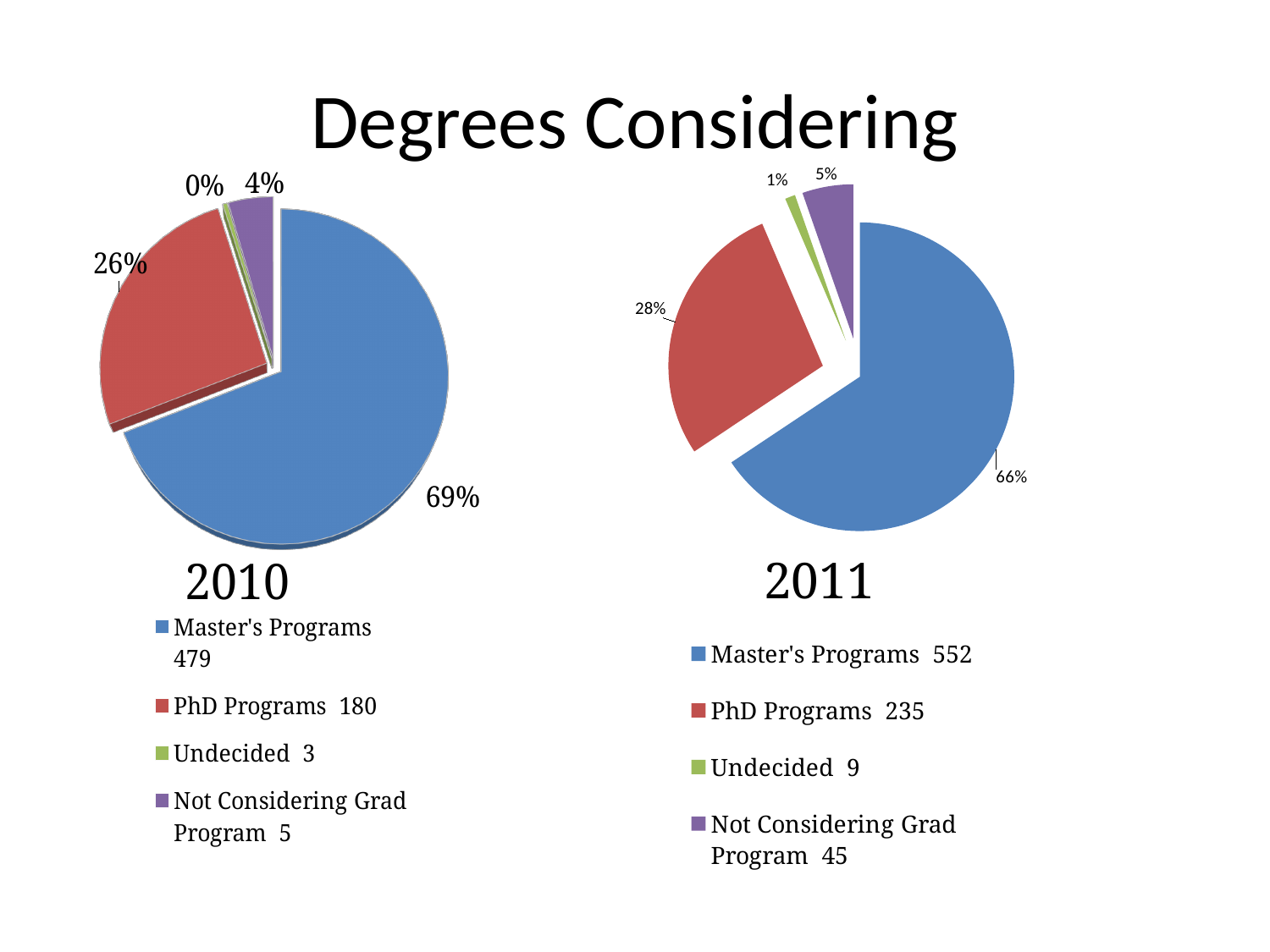
Which is larger: the Undecided count in the 2010 chart or in the 2011 chart? 2011 In the 2011 pie chart, which category has the largest slice? Master's Programs In the 2010 pie chart, which category has the smallest slice? Undecided In the 2010 pie chart, what is the count shown in the legend for PhD Programs? 180 In the 2011 pie chart, what percentage share does PhD Programs have? 28% What is the title of the slide containing the two pie charts? Degrees Considering What type of chart is used for the 2010 data? Pie chart What is the difference between the Master's Programs counts in the 2011 chart and the 2010 chart? 73 In the 2010 pie chart, what percentage share does Master's Programs have? 69% In the 2011 pie chart, what is the count shown in the legend for Not Considering Grad Program? 45 How many categories does the 2011 pie chart's legend list? 4 In the 2010 pie chart, what percentage share is labelled for Not Considering Grad Program? 4%